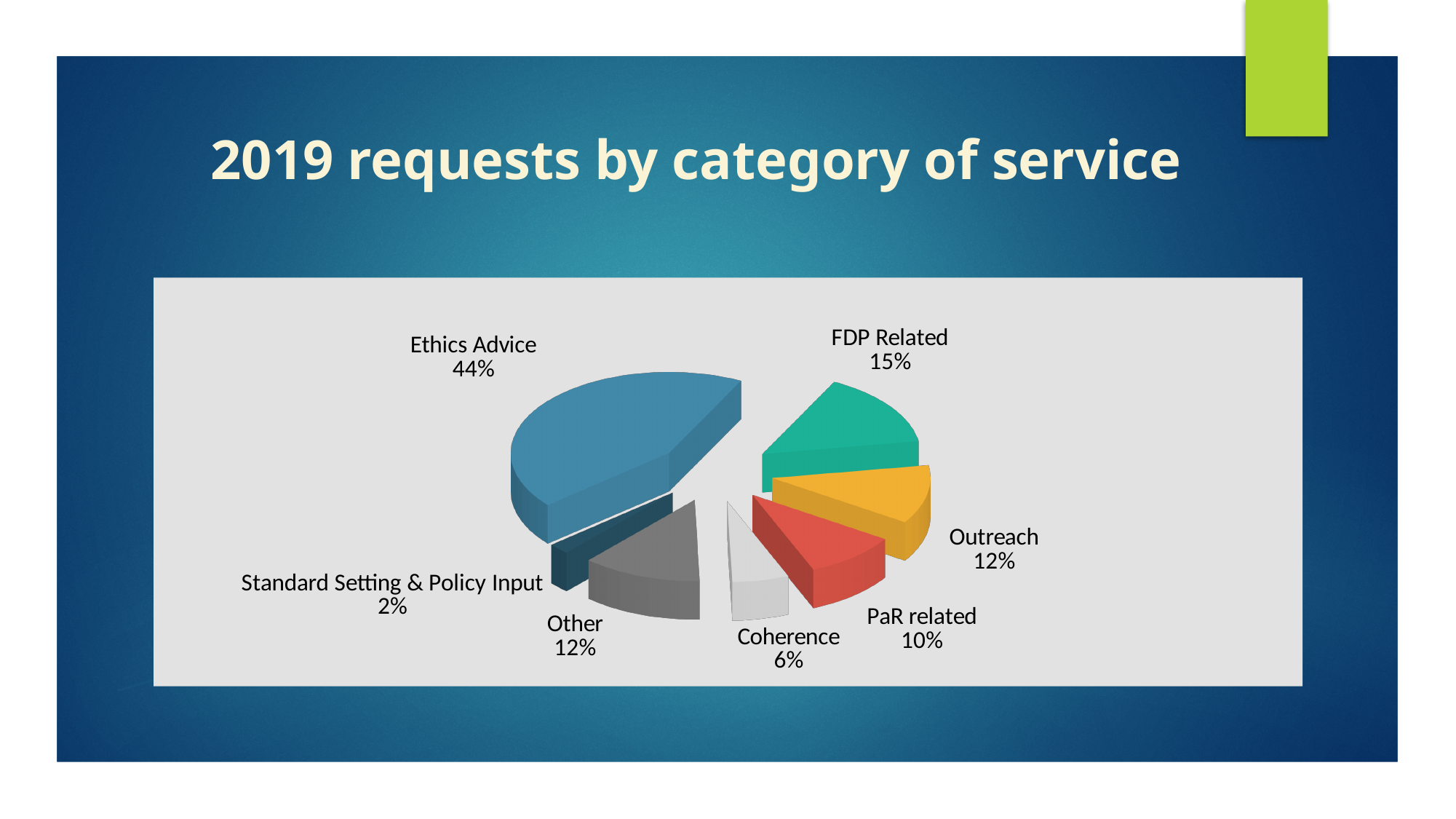
What percentage of requests was FDP Related? 15% How many categories of service are shown in the pie chart? 7 What share of 2019 requests was for Ethics Advice? 44% Which category of service had the largest share of 2019 requests? Ethics Advice What is the title of the chart on the slide? 2019 requests by category of service Which category of service had the smallest share of 2019 requests? Standard Setting & Policy Input What is the difference in percentage points between Outreach and PaR related? 2 Which has a larger share of requests, FDP Related or Outreach? FDP Related What percentage of requests was for Standard Setting & Policy Input? 2% What share of requests was for Coherence? 6% How many percentage points larger is the Ethics Advice share than the FDP Related share? 29 What type of chart is shown on the slide? Pie chart